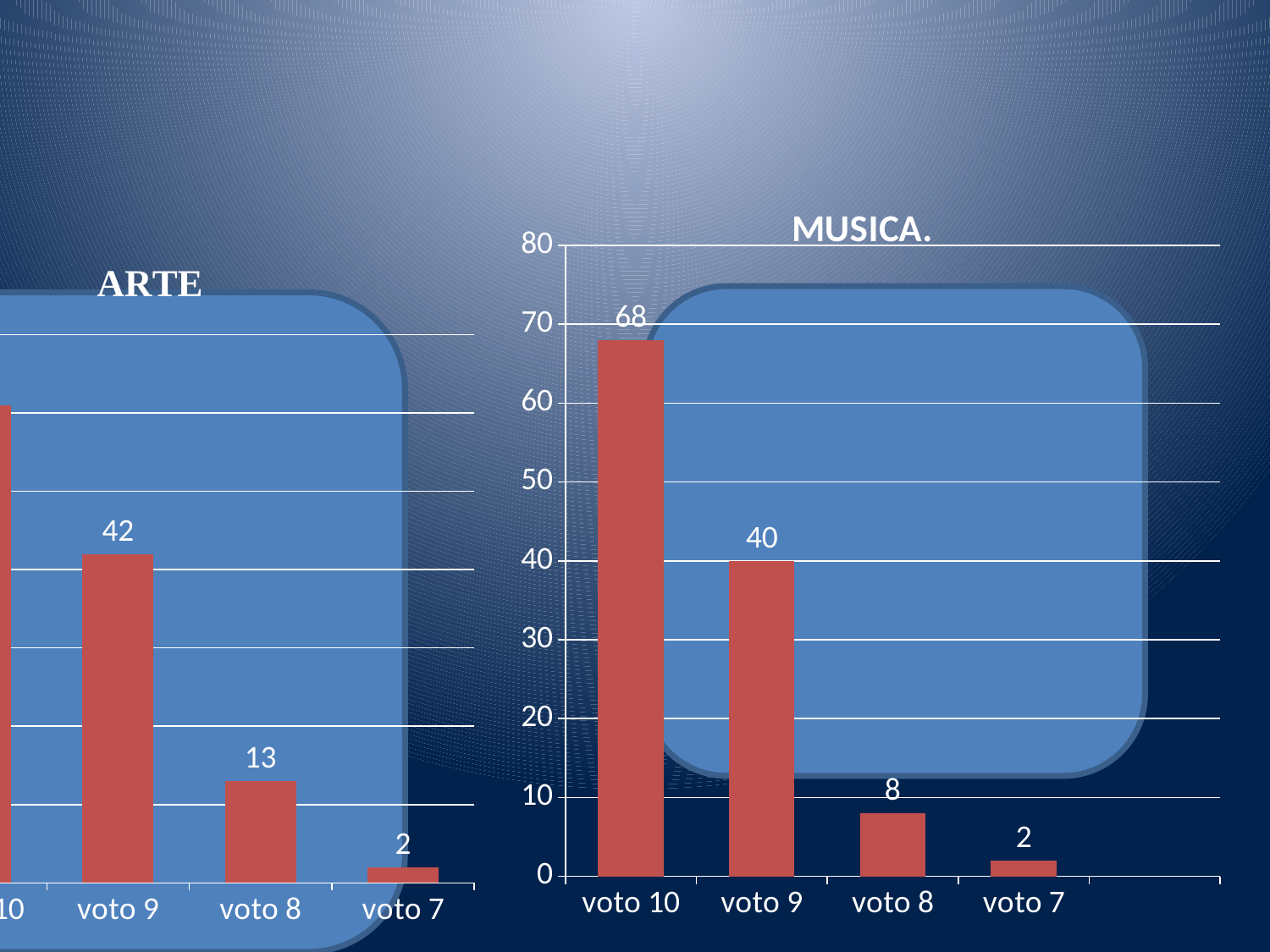
In the MUSICA. chart, what is the value for voto 10? 68 In the MUSICA. chart, do the values rise or fall from voto 10 to voto 7? fall In the ARTE chart, what is the value for voto 8? 13 Which is larger: the value for voto 8 in the ARTE chart or the value for voto 8 in the MUSICA. chart? ARTE In the ARTE chart, what is the value for voto 9? 42 In the MUSICA. chart, which category has the lowest value? voto 7 In the MUSICA. chart, what is the value for voto 9? 40 In the MUSICA. chart, what is the value for voto 8? 8 What kind of chart is the MUSICA. chart? bar chart In the MUSICA. chart, which category has the highest value? voto 10 In the MUSICA. chart, what is the difference between the values for voto 10 and voto 9? 28 In the MUSICA. chart, how many categories are shown on the x axis? 4